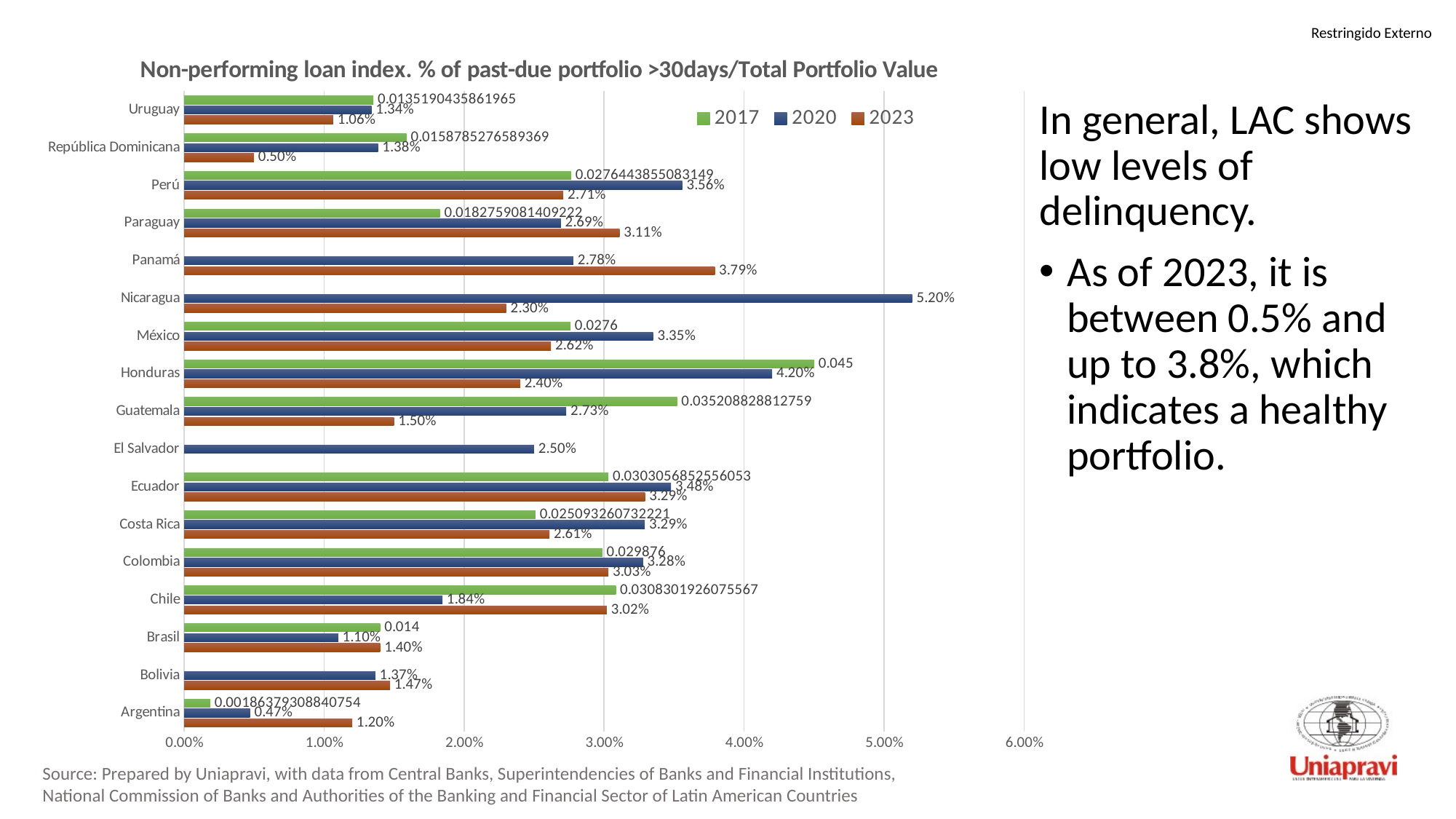
How many countries are listed on the chart? 17 Which country has the lowest 2023 value? República Dominicana What is the 2017 value shown for Honduras? 0.045 What is the difference between Nicaragua's 2020 value and its 2023 value? 2.90% Is the 2017 value for Honduras greater or less than 4.00%? greater How many series does the legend list? 3 What is the 2023 value for República Dominicana? 0.50% What is the 2020 value for Nicaragua? 5.20% What is the 2023 value for Panamá? 3.79% For Paraguay, which is larger: the 2020 value or the 2023 value? 2023 Which country has the highest 2020 value? Nicaragua What kind of chart is shown on the slide? bar chart